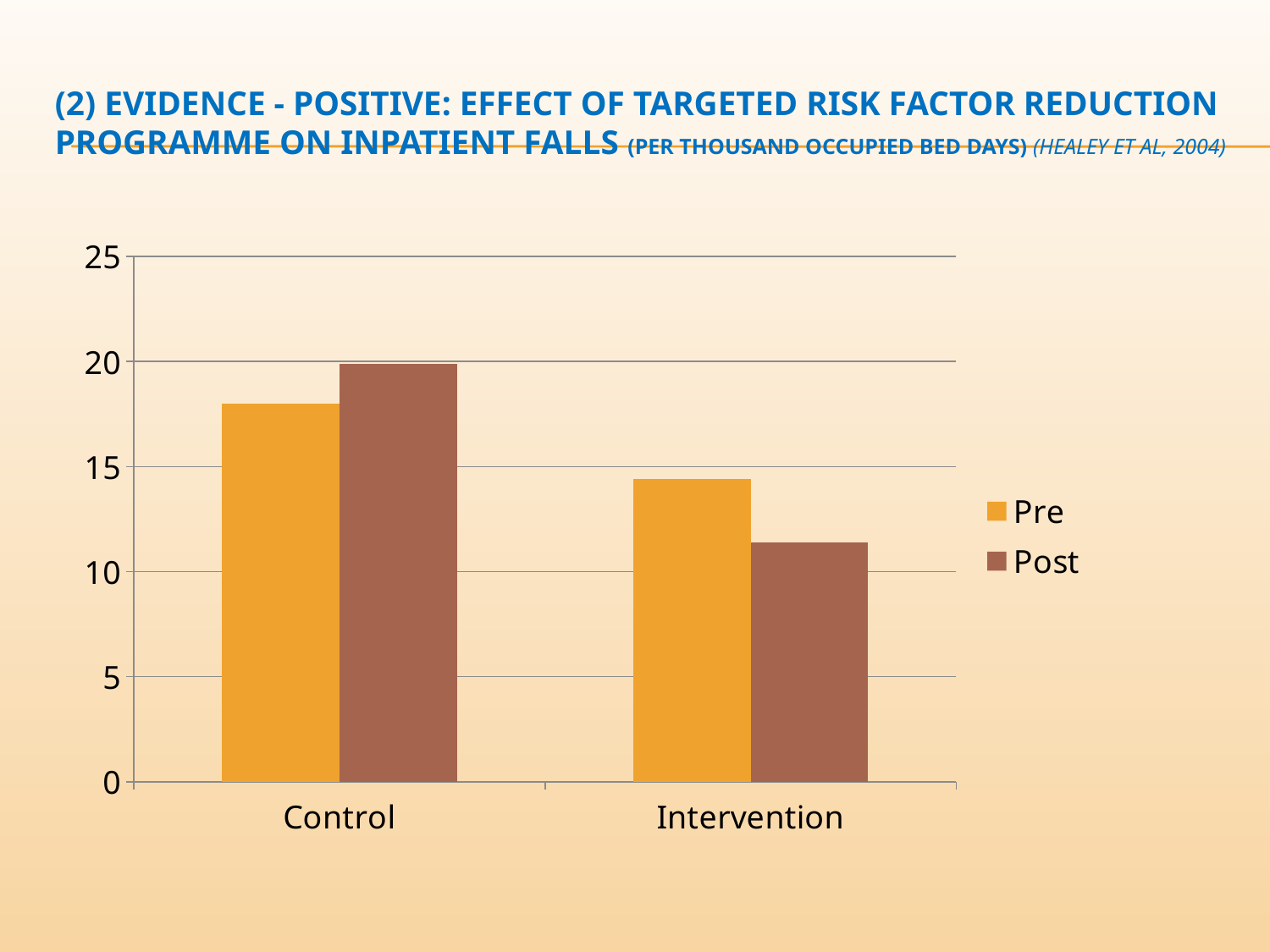
What kind of chart is shown on the slide? bar chart Which category and series has the highest bar? Control, Post Is the Post value for Control greater or less than 15? greater Is the Post value for Intervention greater or less than 15? less For Control, which is larger, the Pre value or the Post value? Post What are the two entries listed in the legend? Pre and Post How many categories are shown on the x axis? 2 How many series does the legend list? 2 For Intervention, which is larger, the Pre value or the Post value? Pre Is the Pre value for Control greater or less than 15? greater Which category and series has the lowest bar? Intervention, Post